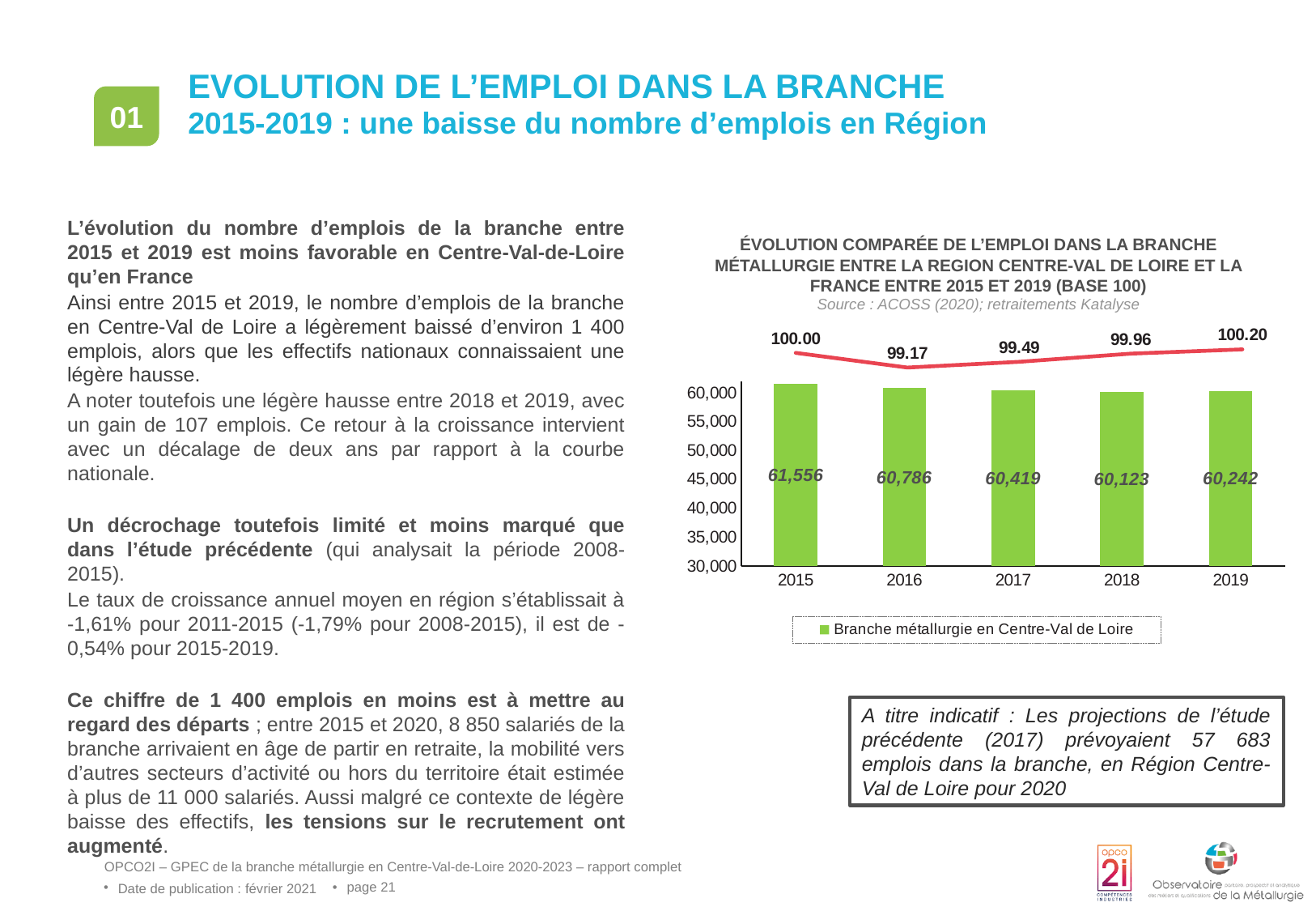
What is the value of the bar for 2019 in the chart? 60,242 What is the value of the bar for 2015 in the chart? 61,556 How many series does the legend of the chart list? 1 Which bar is larger, 2016 or 2017? 2016 What is the label of the red line's data point for 2016? 99.17 Which year has the lowest bar in the chart? 2018 What kind of chart is used to show the Branche métallurgie en Centre-Val de Loire values? Bar chart What is the difference between the bar values for 2015 and 2019? 1,314 Which year has the highest bar in the chart? 2015 How many years are shown on the x axis of the chart? 5 What is the value of the bar for 2018 in the chart? 60,123 Do the bar values rise or fall from 2015 to 2018? Fall